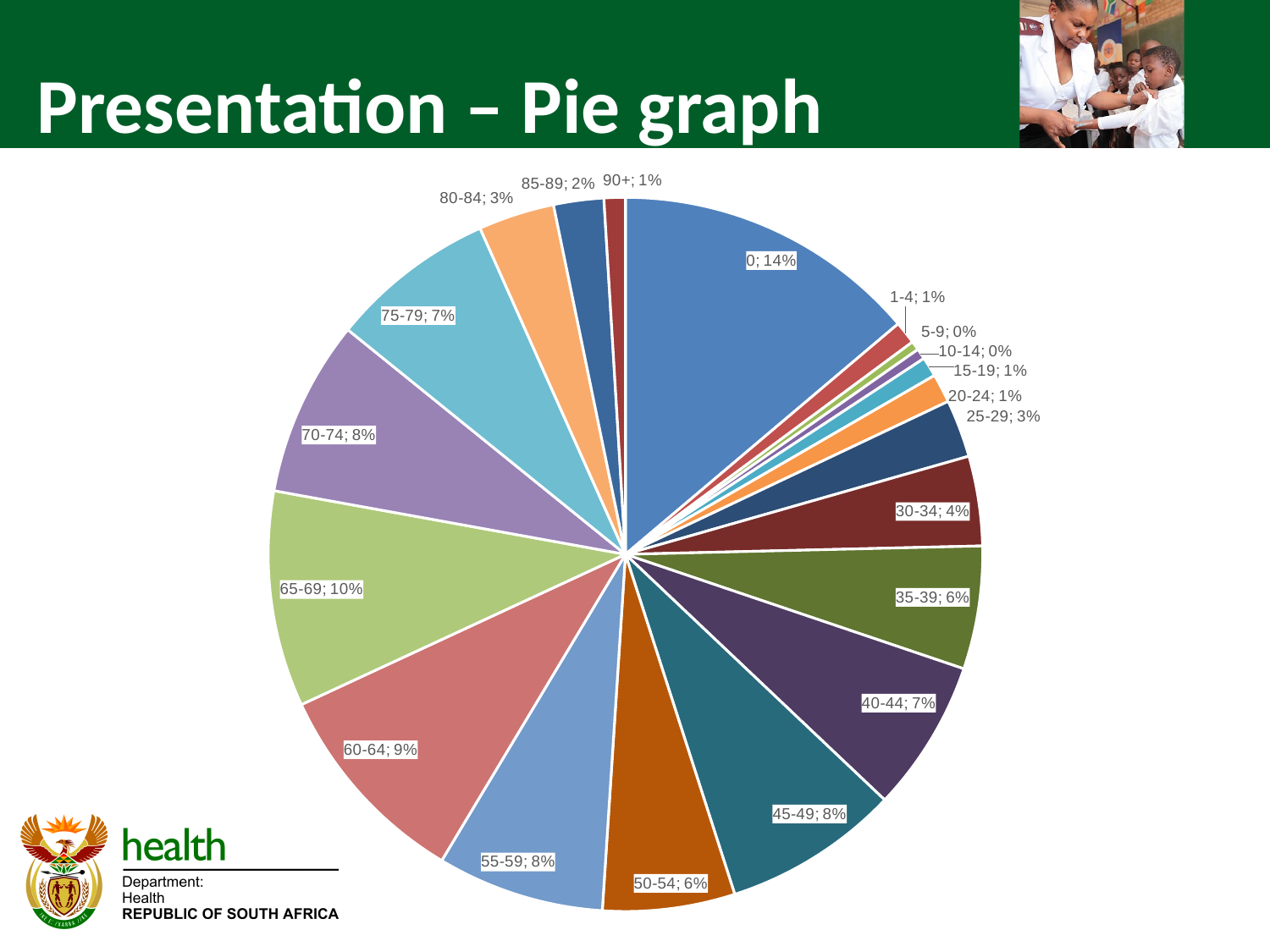
What percentage is shown for the 90+ age group? 1% What kind of chart is shown on the slide? pie chart What is the share of the pie for the 60-64 age group? 9% How many slices does the pie chart have? 20 What percentage is shown for the 30-34 age group? 4% What percentage is shown for the 65-69 age group? 10% Which age group has the largest share of the pie? 0 What is the difference in percentage points between the 0 age group and the 65-69 age group? 4 Which has a larger share, the 40-44 age group or the 45-49 age group? 45-49 What percentage is shown for the 80-84 age group? 3% What is the difference in percentage points between the 75-79 age group and the 85-89 age group? 5 What is the slide title? Presentation – Pie graph